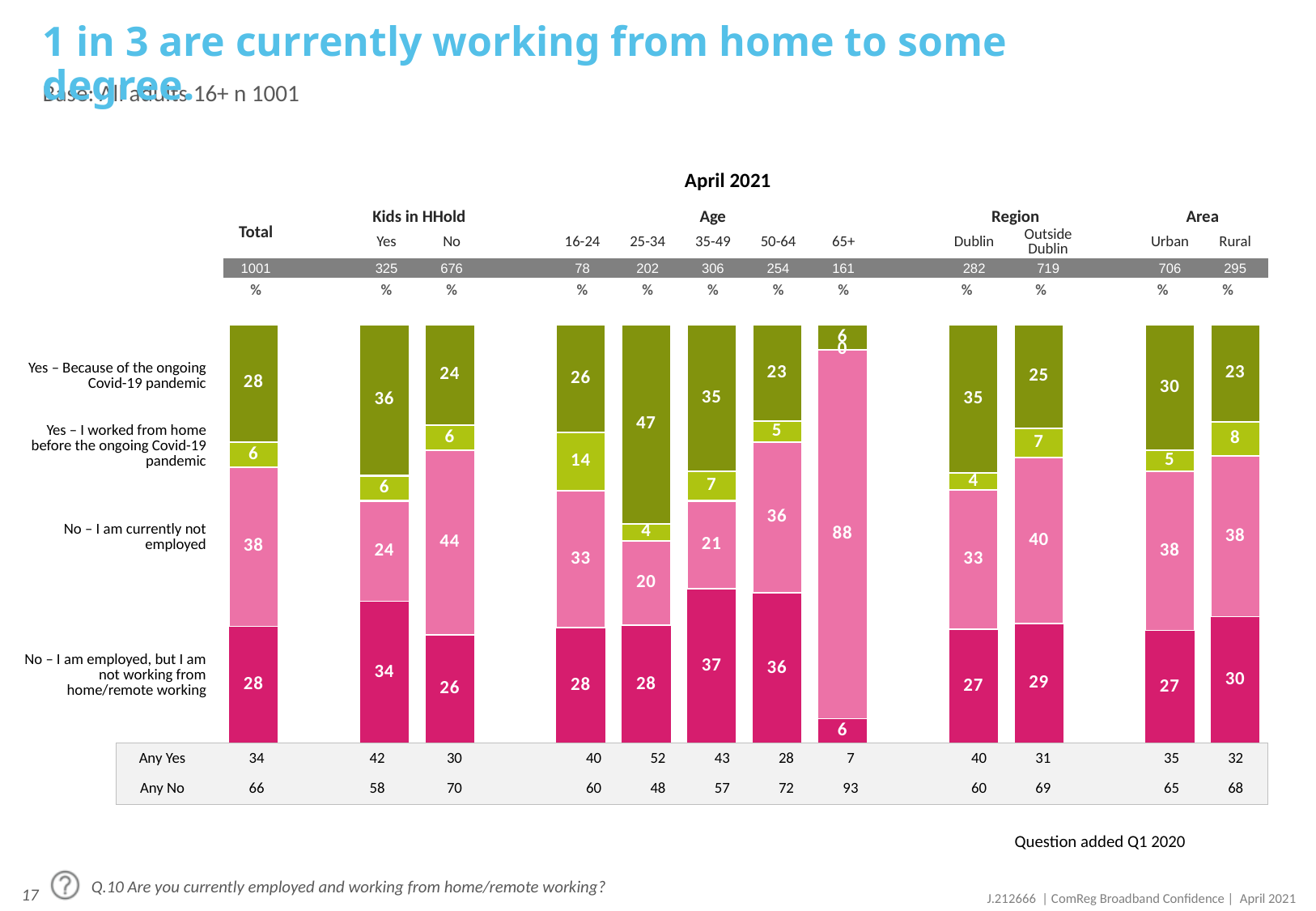
What kind of chart is shown on the slide? Stacked bar chart What is the value for 'Yes – I worked from home before the ongoing Covid-19 pandemic' in the Rural bar? 8 Which age group has the highest value for 'No – I am currently not employed'? 65+ Which has the larger value for 'Yes – Because of the ongoing Covid-19 pandemic', Dublin or Outside Dublin? Dublin How many stacked bars are shown in the chart? 12 What is the base size (n) shown for the Urban column? 706 What is the value for 'No – I am employed, but I am not working from home/remote working' in the 65+ bar? 6 What is the value for 'Yes – Because of the ongoing Covid-19 pandemic' in the 25-34 age group bar? 47 What is the value for 'Yes – Because of the ongoing Covid-19 pandemic' in the Total bar? 28 What is the 'Any Yes' value for the 25-34 age group? 52 What is the difference between the Kids in HHold 'Yes' and 'No' bars for 'No – I am employed, but I am not working from home/remote working'? 8 Which age group has the lowest value for 'Yes – Because of the ongoing Covid-19 pandemic'? 65+